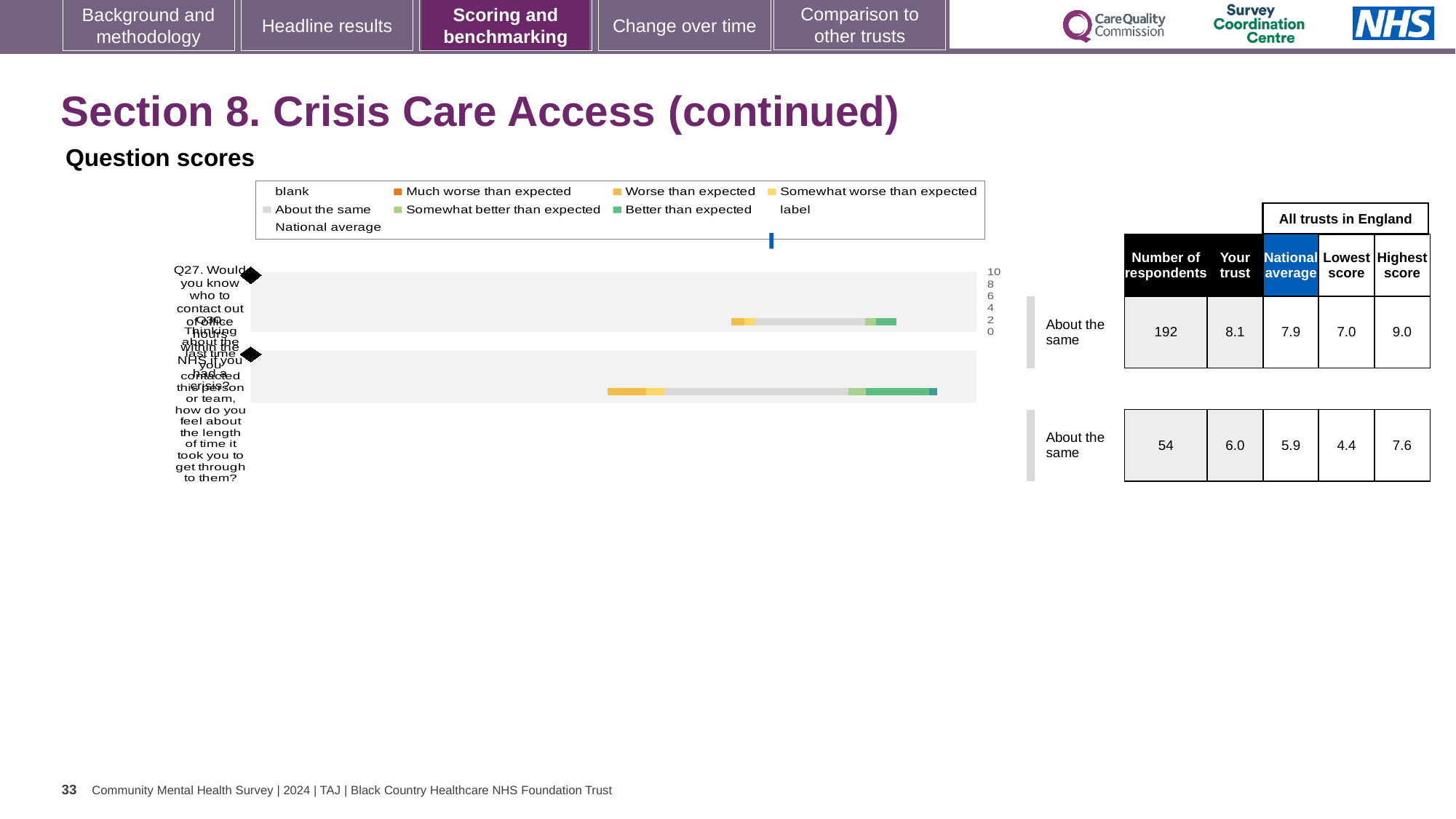
Which question has the higher 'Your trust' score, Q27 or Q30? Q27 What is the lowest score among all trusts in England for Q30? 4.4 What kind of chart is used to show the question scores on this slide? bar chart What is the highest score among all trusts in England for Q27? 9.0 How many respondents answered Q27? 192 What benchmark category is shown for both Q27 and Q30? About the same What is the national average score for Q30 (length of time it took to get through)? 5.9 What is the 'Your trust' score for Q27 (would you know who to contact out of office hours)? 8.1 How many survey questions are plotted in the question scores chart? 2 What is the difference between the trust's score and the national average for Q27? 0.2 How many respondents answered Q30? 54 Is the trust's score for Q30 greater or less than 8? less